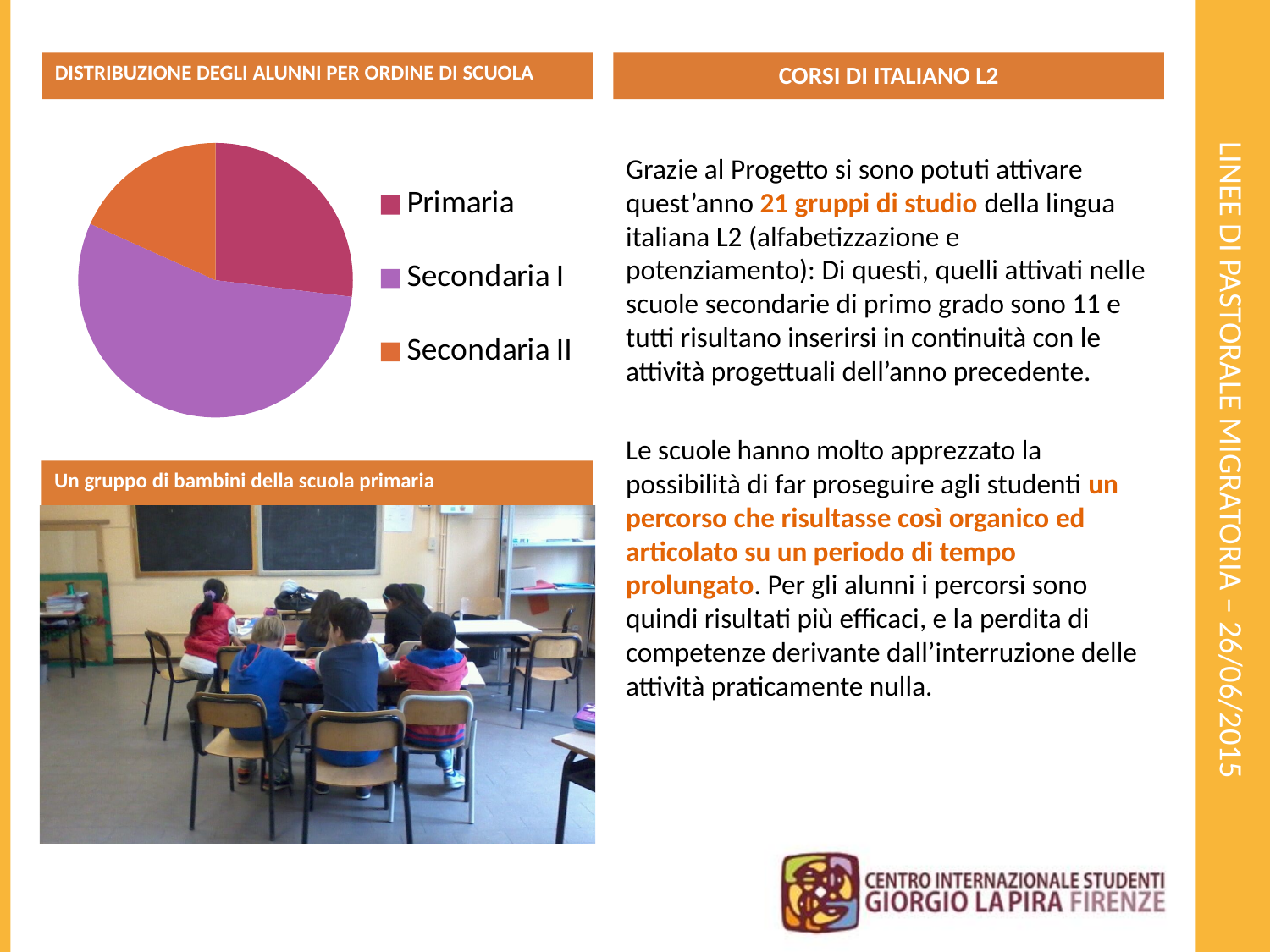
What kind of chart is shown under the heading "DISTRIBUZIONE DEGLI ALUNNI PER ORDINE DI SCUOLA"? Pie chart Does the Secondaria I slice take up more or less than half of the pie chart? More In the pie chart, which slice is larger: Primaria or Secondaria II? Primaria How many slices does the pie chart have? 3 Which category has the smallest slice in the pie chart? Secondaria II How many entries does the legend of the pie chart list? 3 In the pie chart, which slice is larger: Secondaria I or Primaria? Secondaria I What is the title shown above the pie chart? DISTRIBUZIONE DEGLI ALUNNI PER ORDINE DI SCUOLA Which colour represents Secondaria II in the pie chart? Orange Which category has the largest slice in the pie chart? Secondaria I